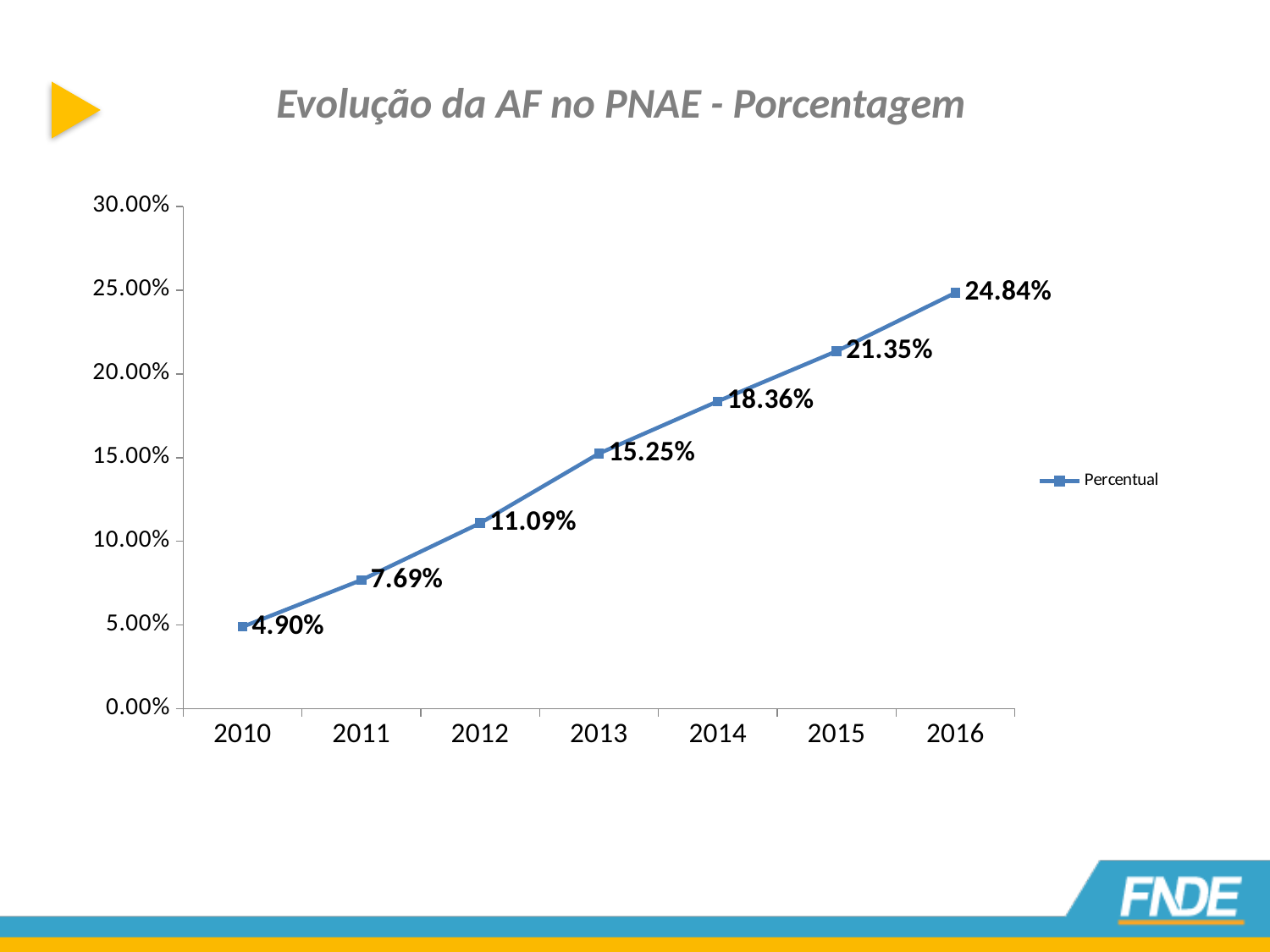
Which year has the highest value? 2016 How many years are plotted on the chart? 7 What is the value for 2013? 15.25% Is the value for 2015 greater or less than 20.00%? greater What is the value for 2016? 24.84% What is the difference between the values for 2016 and 2015? 3.49% Which year has the lowest value? 2010 What kind of chart is shown? line chart What is the value for 2010? 4.90% Do the values rise or fall from 2010 to 2016? rise What is the difference between the values for 2012 and 2011? 3.40% Which is larger, the value for 2014 or the value for 2012? 2014